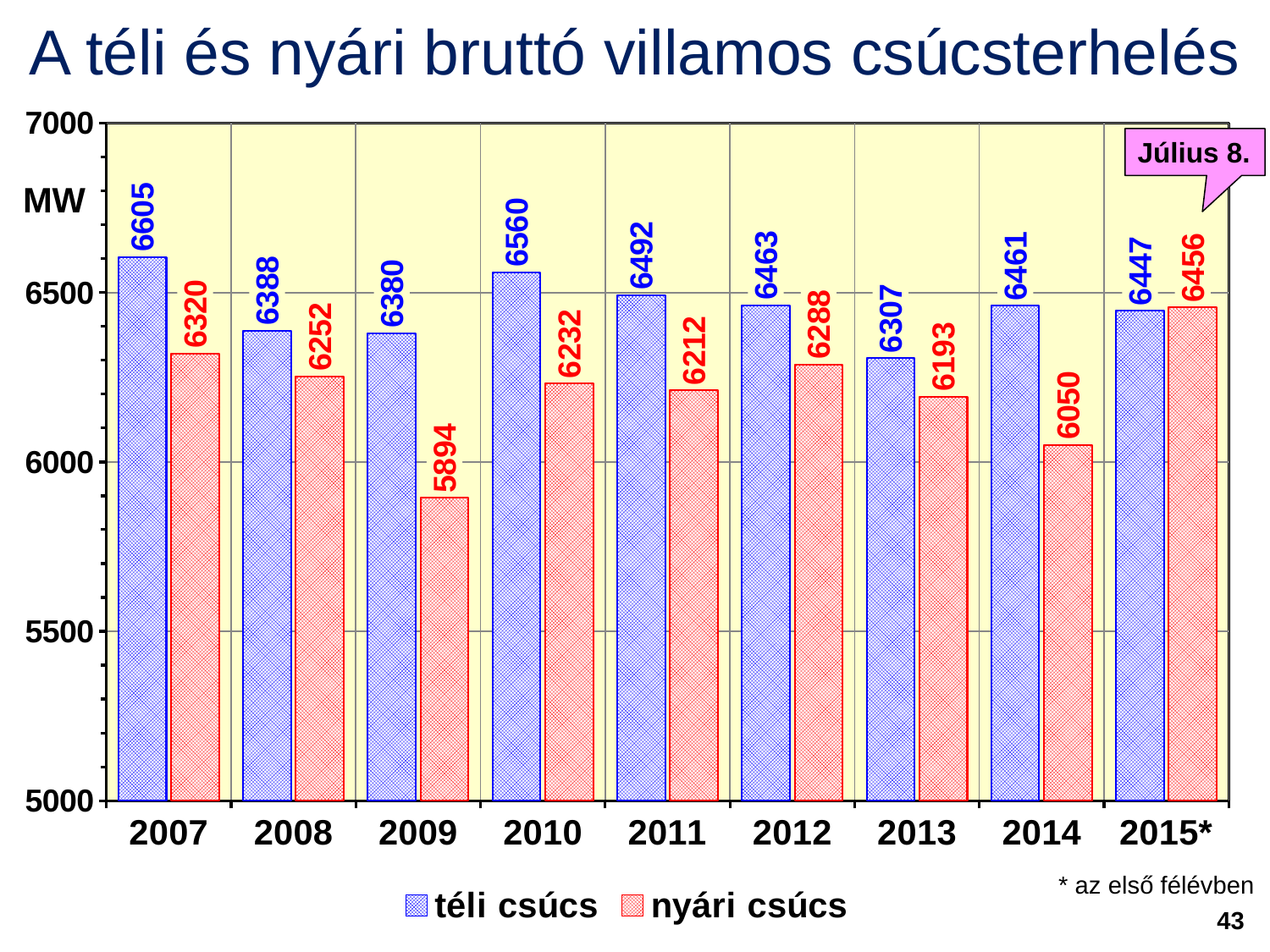
How many series does the legend list? 2 Which is larger for 2015*, the téli csúcs or the nyári csúcs value? nyári csúcs Which year has the highest téli csúcs value? 2007 Is the nyári csúcs value for 2009 greater or less than 6000? less Which year has the lowest nyári csúcs value? 2009 What is the value of téli csúcs for 2007? 6605 What is the difference between the téli csúcs and nyári csúcs values for 2014? 411 What unit is shown on the y axis of the chart? MW How many years are shown on the x axis? 9 What kind of chart is shown on the slide? bar chart What is the value of nyári csúcs for 2009? 5894 What is the value of nyári csúcs for 2015*? 6456